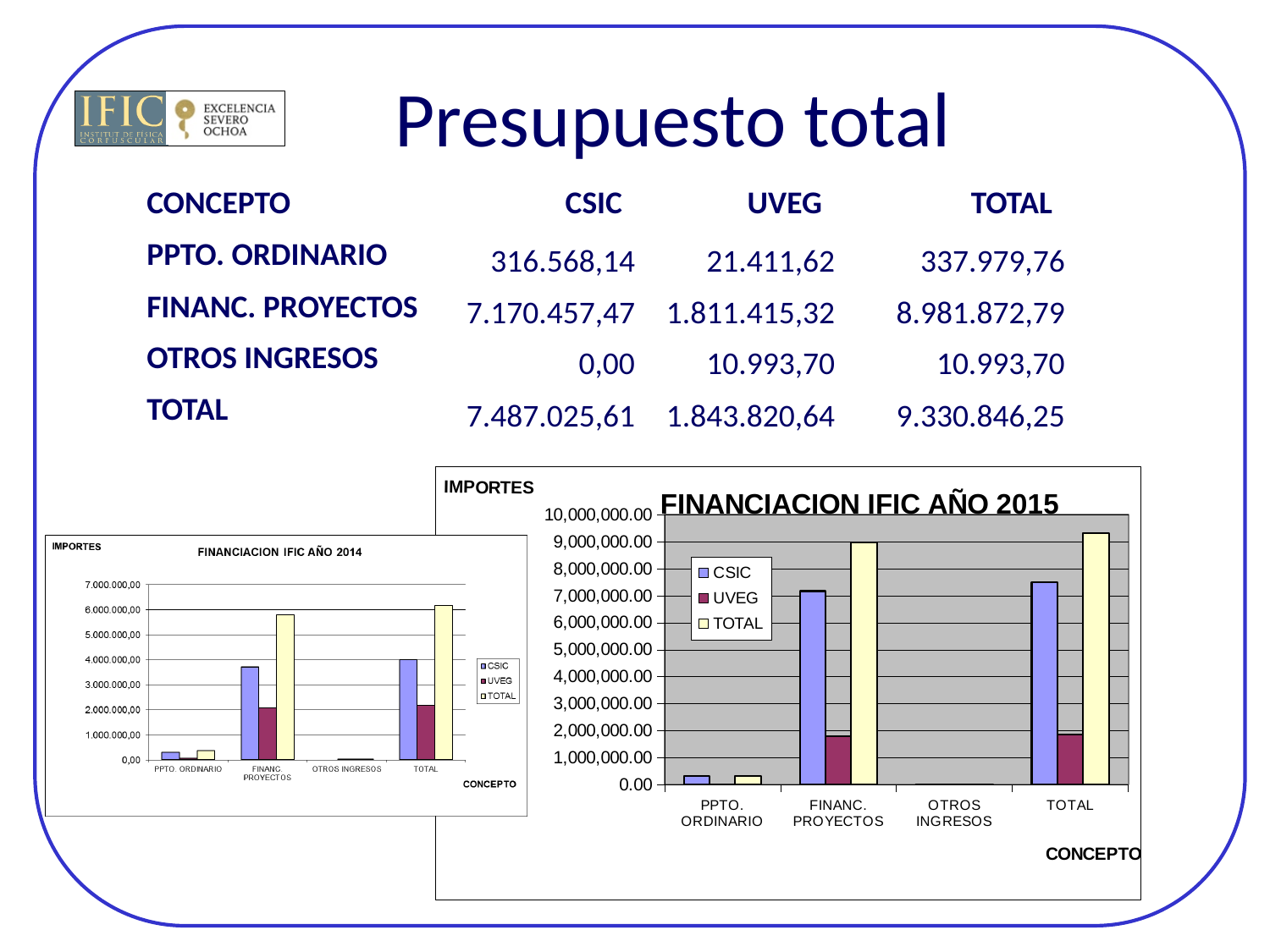
In the FINANCIACION IFIC AÑO 2015 chart, is the CSIC value for FINANC. PROYECTOS greater or less than 6,000,000.00? greater In the FINANCIACION IFIC AÑO 2015 chart, which category has the lowest bars overall? OTROS INGRESOS In the FINANCIACION IFIC AÑO 2015 chart, which is larger for PPTO. ORDINARIO, CSIC or UVEG? CSIC What kind of chart is the FINANCIACION IFIC AÑO 2014 chart? bar chart In the FINANCIACION IFIC AÑO 2015 chart, is the UVEG value for FINANC. PROYECTOS greater or less than 2,000,000.00? less What kind of chart is the FINANCIACION IFIC AÑO 2015 chart? bar chart In the FINANCIACION IFIC AÑO 2014 chart, is the CSIC value for FINANC. PROYECTOS greater or less than 4.000.000,00? less In the FINANCIACION IFIC AÑO 2015 chart, which category has the highest TOTAL bar? TOTAL How many series does the legend of the FINANCIACION IFIC AÑO 2015 chart list? 3 According to the slide, what is the TOTAL value for FINANC. PROYECTOS plotted in the FINANCIACION IFIC AÑO 2015 chart? 8.981.872,79 How many categories are shown on the x axis of the FINANCIACION IFIC AÑO 2015 chart? 4 What is the title of the larger chart on the right of the slide? FINANCIACION IFIC AÑO 2015